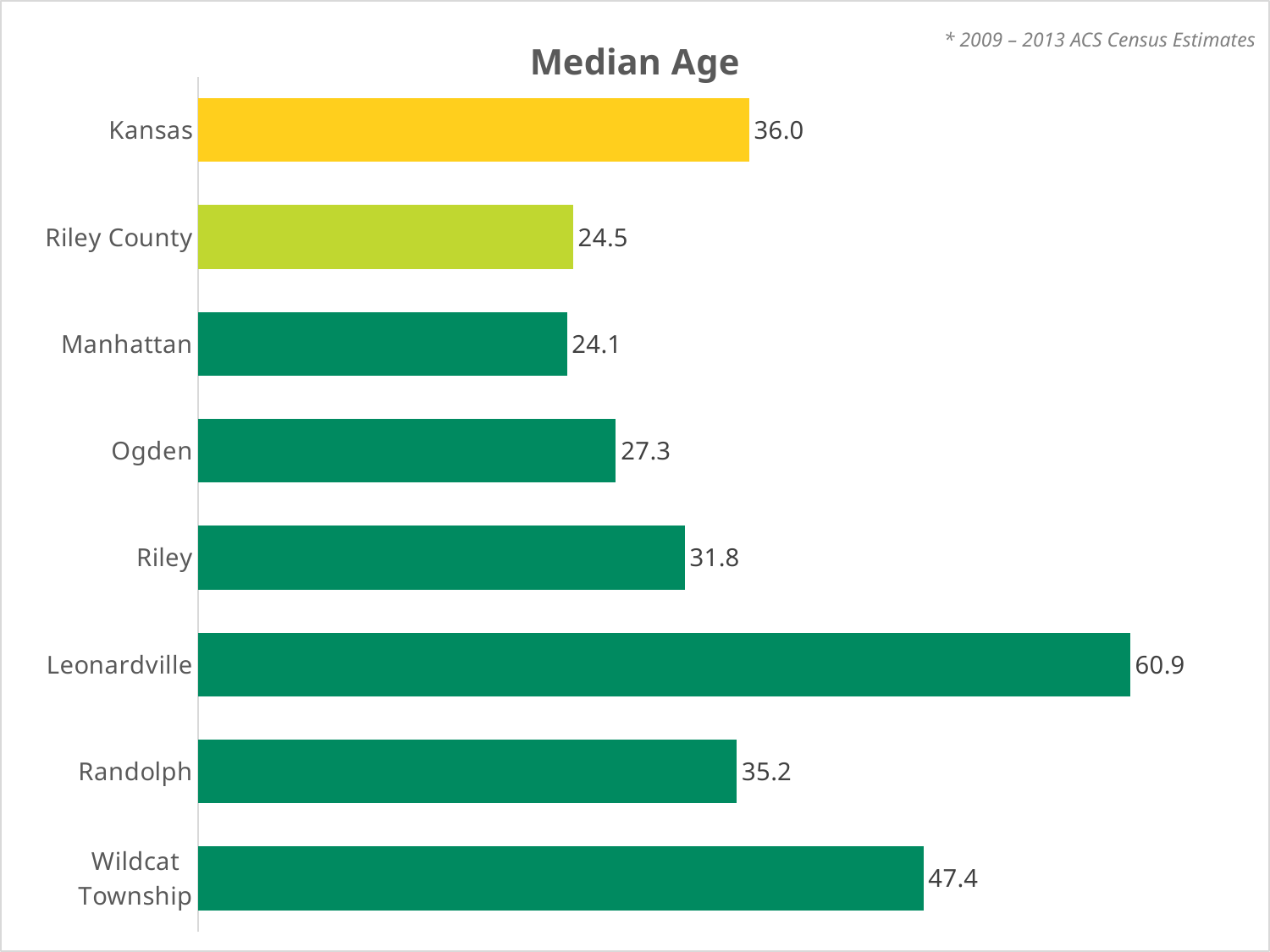
What is the title of the chart? Median Age What is the median age shown for Leonardville? 60.9 Which has a higher median age, Ogden or Riley? Riley What kind of chart is shown on the slide? Bar chart What is the median age shown for Kansas? 36.0 What is the difference between the median age of Leonardville and Manhattan? 36.8 Which category has the lowest median age? Manhattan What is the median age shown for Riley County? 24.5 How many categories are shown in the chart? 8 Which category has the highest median age? Leonardville What is the median age shown for Wildcat Township? 47.4 What is the difference between the median age of Kansas and Riley County? 11.5